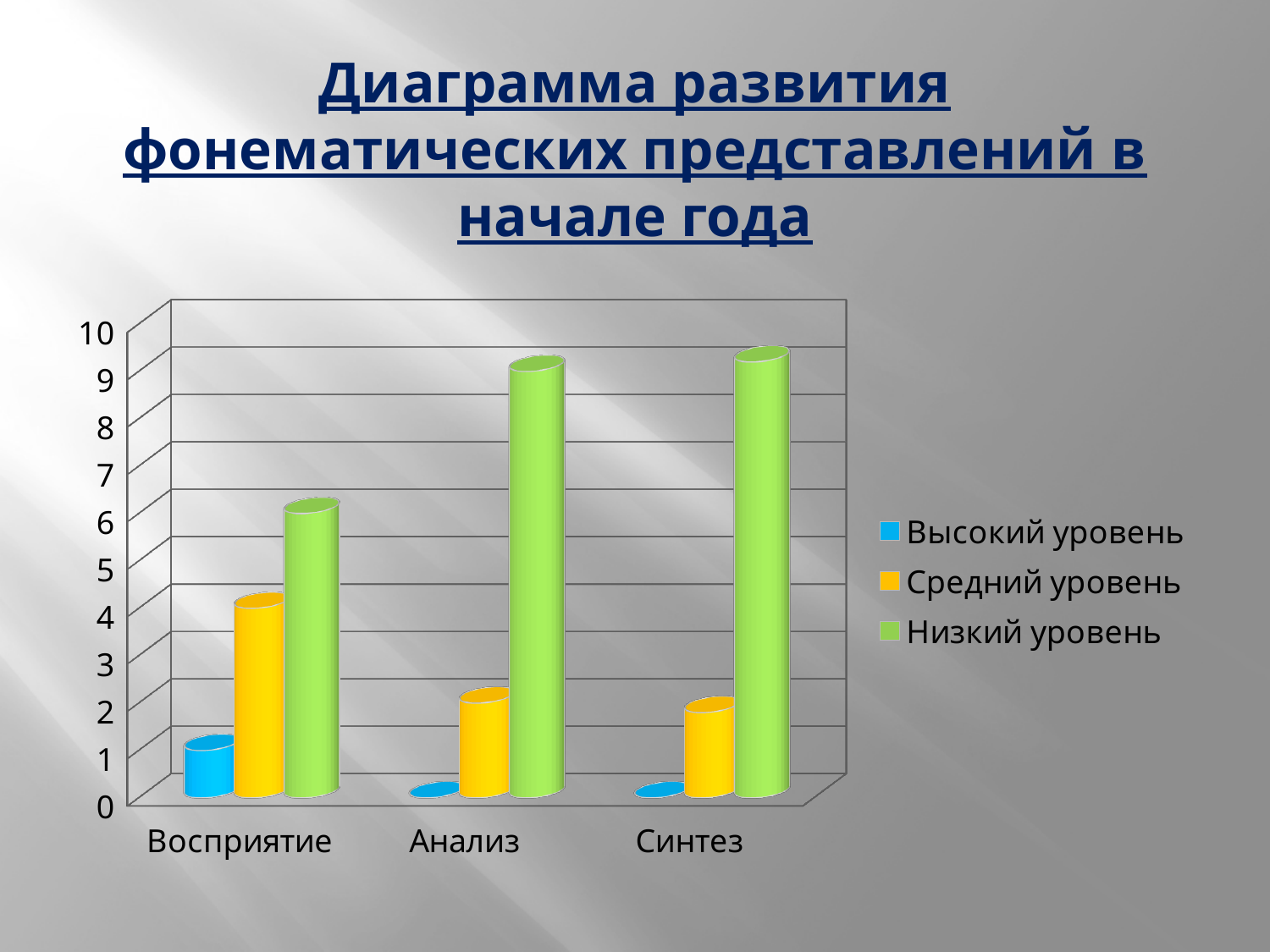
How many categories are shown on the x axis? 3 Which series has the lowest value for Восприятие? Высокий уровень What colour represents Низкий уровень in the legend? green Is the value for Средний уровень in Восприятие greater or less than 2? greater How many series does the legend list? 3 Is the value for Низкий уровень in Восприятие greater or less than 8? less Which category has the highest value for Средний уровень? Восприятие What kind of chart is shown on the slide? bar chart Which series has the highest value for Анализ? Низкий уровень Is the value for Низкий уровень in Анализ greater or less than 5? greater Which category has the highest value for Высокий уровень? Восприятие Which is larger: Средний уровень for Восприятие or Средний уровень for Синтез? Восприятие